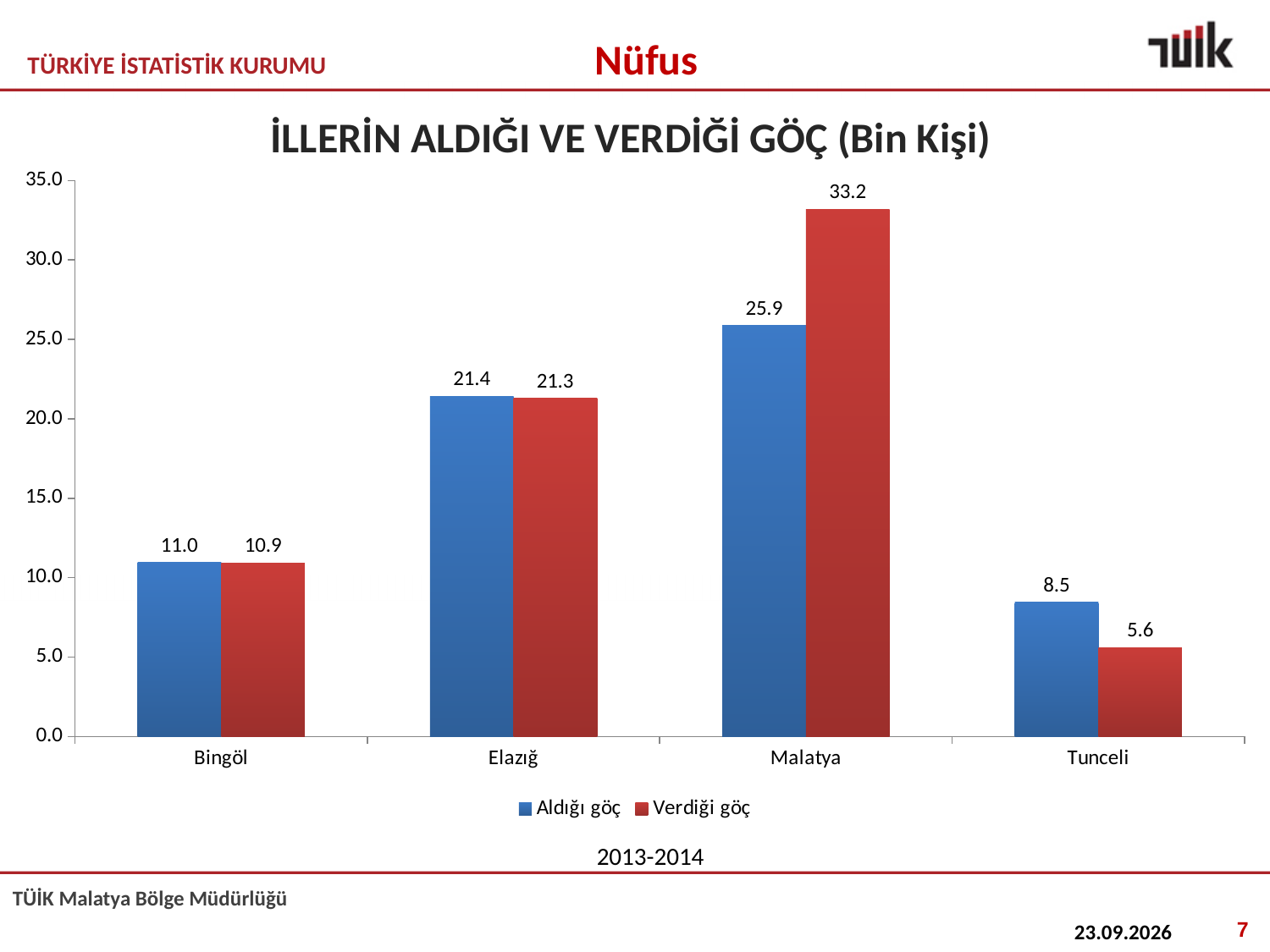
What is the difference between Verdiği göç and Aldığı göç for Malatya? 7.3 Which province has the highest Verdiği göç value? Malatya For Tunceli, which is larger: Aldığı göç or Verdiği göç? Aldığı göç What is the value of Verdiği göç for Bingöl? 10.9 How many provinces are shown on the x axis? 4 Which province has the lowest Aldığı göç value? Tunceli What is the difference between Aldığı göç and Verdiği göç for Tunceli? 2.9 What type of chart is shown on the slide? Bar chart How many series does the legend list? 2 Is the Verdiği göç value for Malatya greater or less than 30.0? greater What is the value of Verdiği göç for Tunceli? 5.6 What is the value of Aldığı göç for Malatya? 25.9